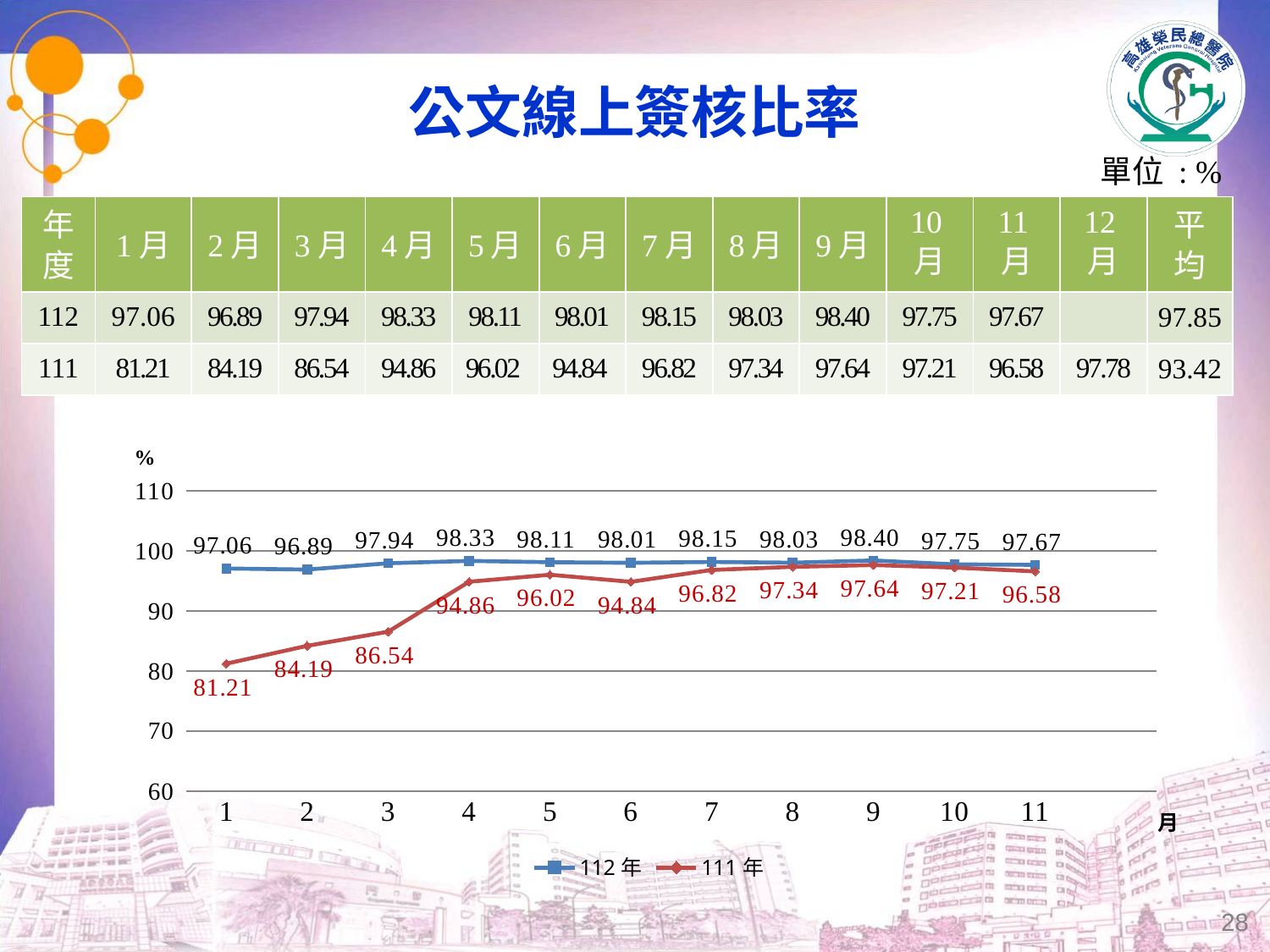
In month 6, which series has the larger value, 112年 or 111年? 112年 What is the value for 112年 in month 9? 98.40 Is the value for 111年 in month 3 greater or less than 90? less What is the difference between the 112年 and 111年 values in month 1? 15.85 Does the 111年 series rise or fall from month 1 to month 4? rise What kind of chart is shown on the slide? line chart What is the value for 111年 in month 1? 81.21 In which month does the 112年 series reach its highest value? 9 How many series does the chart legend list? 2 How many months are plotted on the x axis of the chart? 11 In which month does the 111年 series have its lowest value? 1 What is the title of the slide containing the chart? 公文線上簽核比率